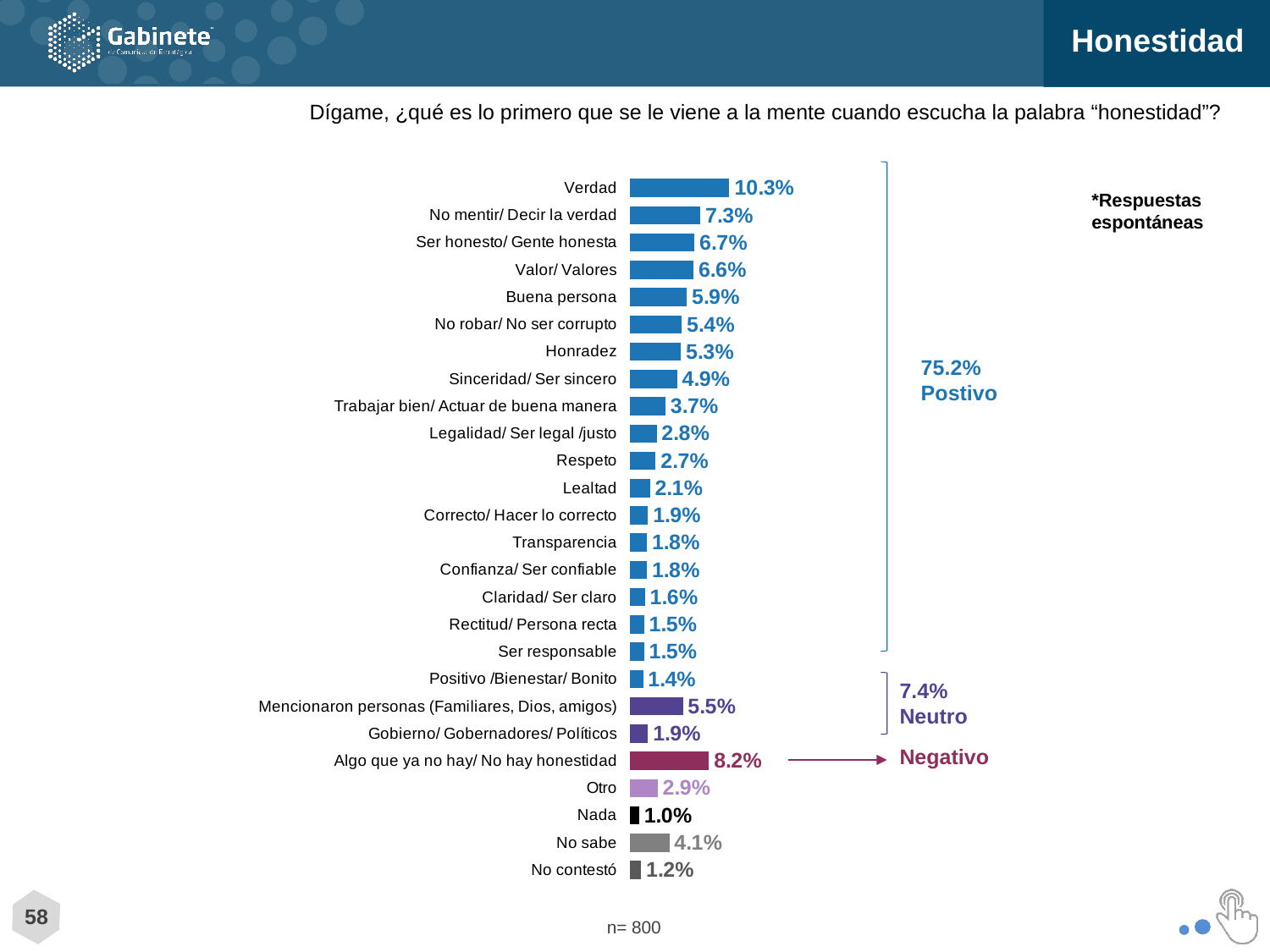
Which category has the lowest value? Nada Which category has the highest value? Verdad How many categories are shown in the chart? 26 What is the sample size (n) shown on the slide? 800 What is the value for "Verdad"? 10.3% What is the difference between the values for "Verdad" and "No mentir/ Decir la verdad"? 3.0% What percentage is labelled as "Postivo" on the slide? 75.2% What kind of chart is shown on the slide? Bar chart What is the value for "Algo que ya no hay/ No hay honestidad"? 8.2% Which is larger, the value for "Honradez" or the value for "Sinceridad/ Ser sincero"? Honradez What is the value for "Mencionaron personas (Familiares, Dios, amigos)"? 5.5% What is the value for "No sabe"? 4.1%